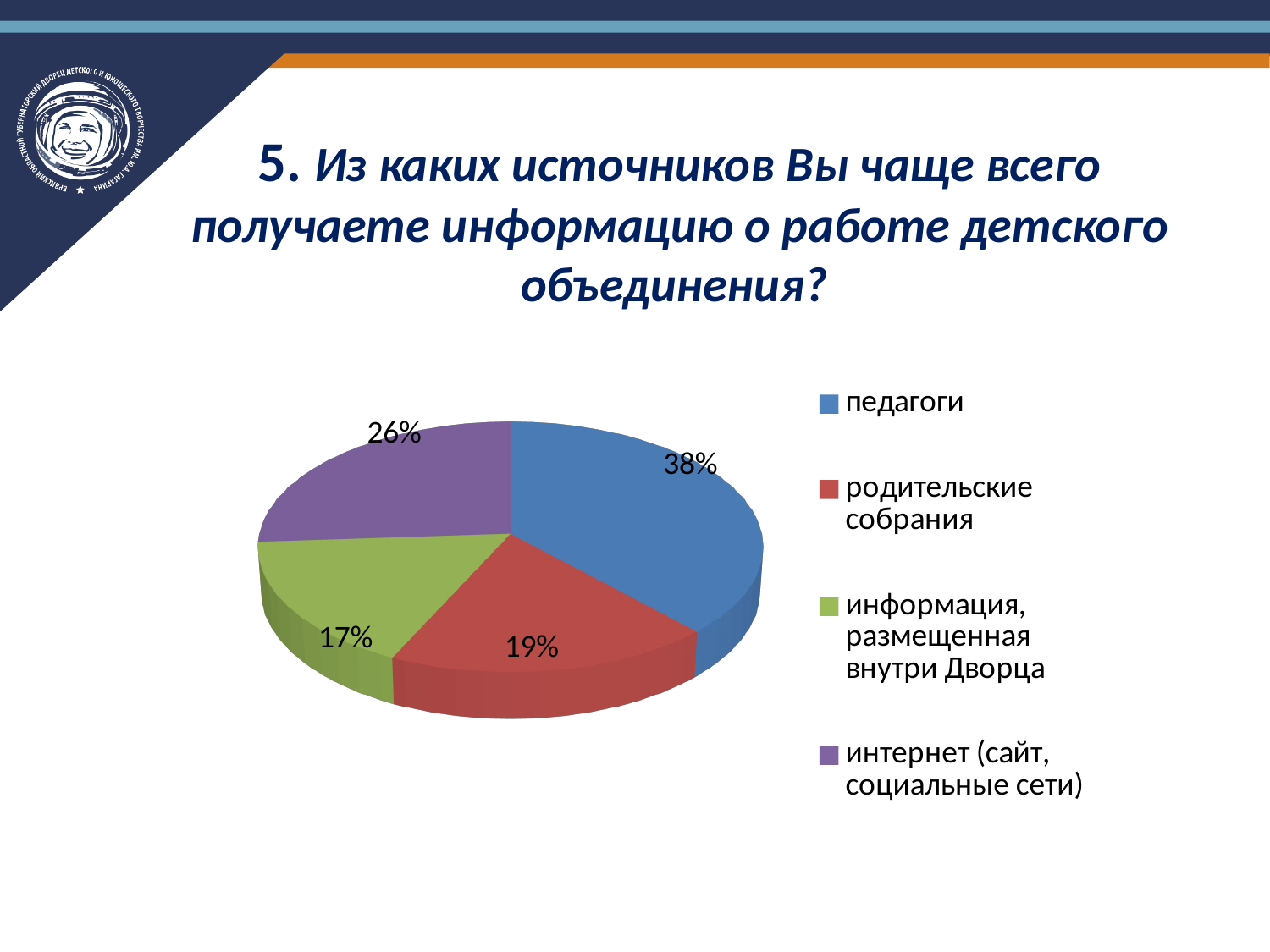
How many slices does the pie chart have? 4 Which category has the largest slice of the pie? педагоги What share of the pie does the slice for информация, размещенная внутри Дворца represent? 17% What kind of chart is shown on the slide? pie chart Which category is shown in purple in the legend? интернет (сайт, социальные сети) What share of the pie does the slice for родительские собрания represent? 19% What share of the pie does the slice for педагоги represent? 38% What share of the pie does the slice for интернет (сайт, социальные сети) represent? 26% Which category has the smallest slice of the pie? информация, размещенная внутри Дворца What colour is the slice for педагоги? blue What is the difference in percentage points between the педагоги slice and the интернет (сайт, социальные сети) slice? 12 Which is larger: the slice for родительские собрания or the slice for интернет (сайт, социальные сети)? интернет (сайт, социальные сети)